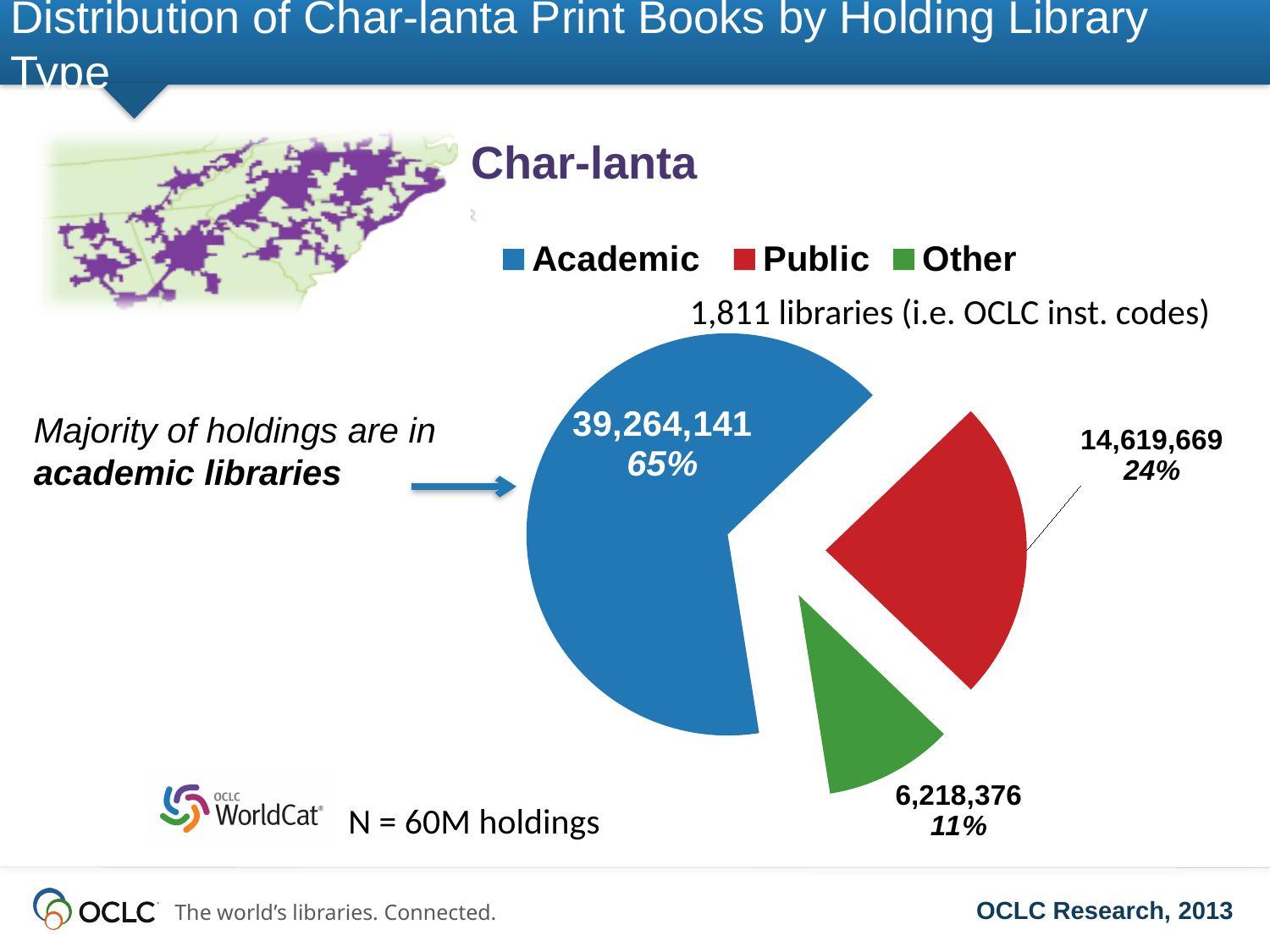
What is the number of holdings for Other libraries? 6,218,376 What percentage share of holdings do Other libraries have? 11% How many categories does the pie chart show? 3 What is the number of holdings for Public libraries? 14,619,669 Which library type has the smallest share of holdings? Other What colour represents Public libraries in the pie chart? Red What type of chart is shown on the slide? Pie chart What is the number of holdings for Academic libraries? 39,264,141 What percentage share of holdings do Public libraries have? 24% Which library type has the largest share of holdings? Academic What percentage share of holdings do Academic libraries have? 65% Which has more holdings, Public or Other libraries? Public